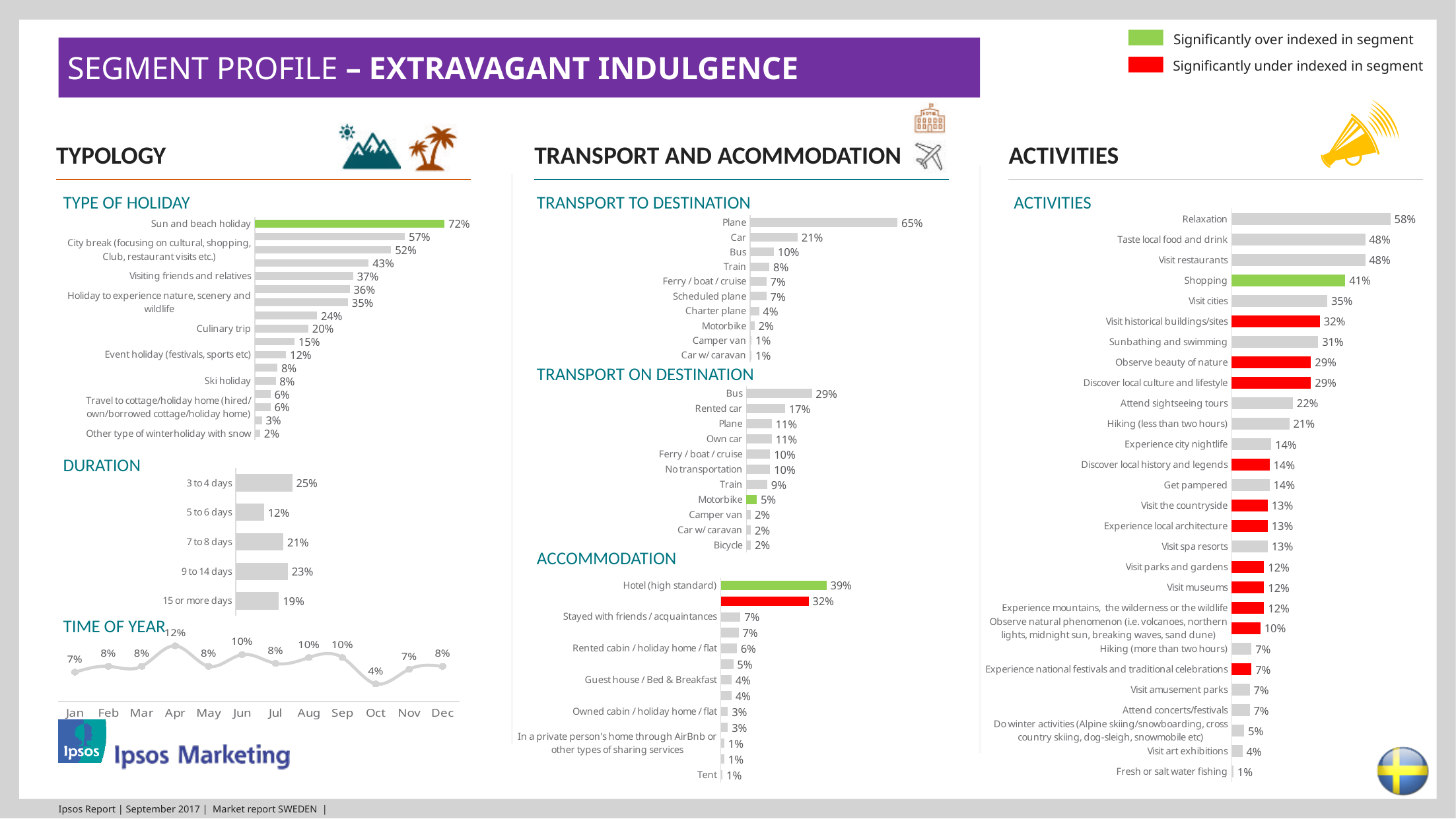
In the Type of Holiday chart, what is the value for Culinary trip? 20% In the Accommodation chart, what is the value for Hotel (high standard)? 39% In the Duration chart, which category has the highest value? 3 to 4 days In the Activities chart, what is the difference between Relaxation and Visit cities? 23% What kind of chart is the Time of Year chart? Line chart How many categories are shown in the Transport to Destination chart? 10 In the Activities chart, what is the value for Shopping? 41% In the Time of Year chart, which month has the lowest value? Oct In the Transport on Destination chart, which is larger, Bus or Rented car? Bus In the Duration chart, what is the difference between 9 to 14 days and 5 to 6 days? 11% In the Transport to Destination chart, what is the value for Plane? 65% In the Type of Holiday chart, what is the value for Sun and beach holiday? 72%